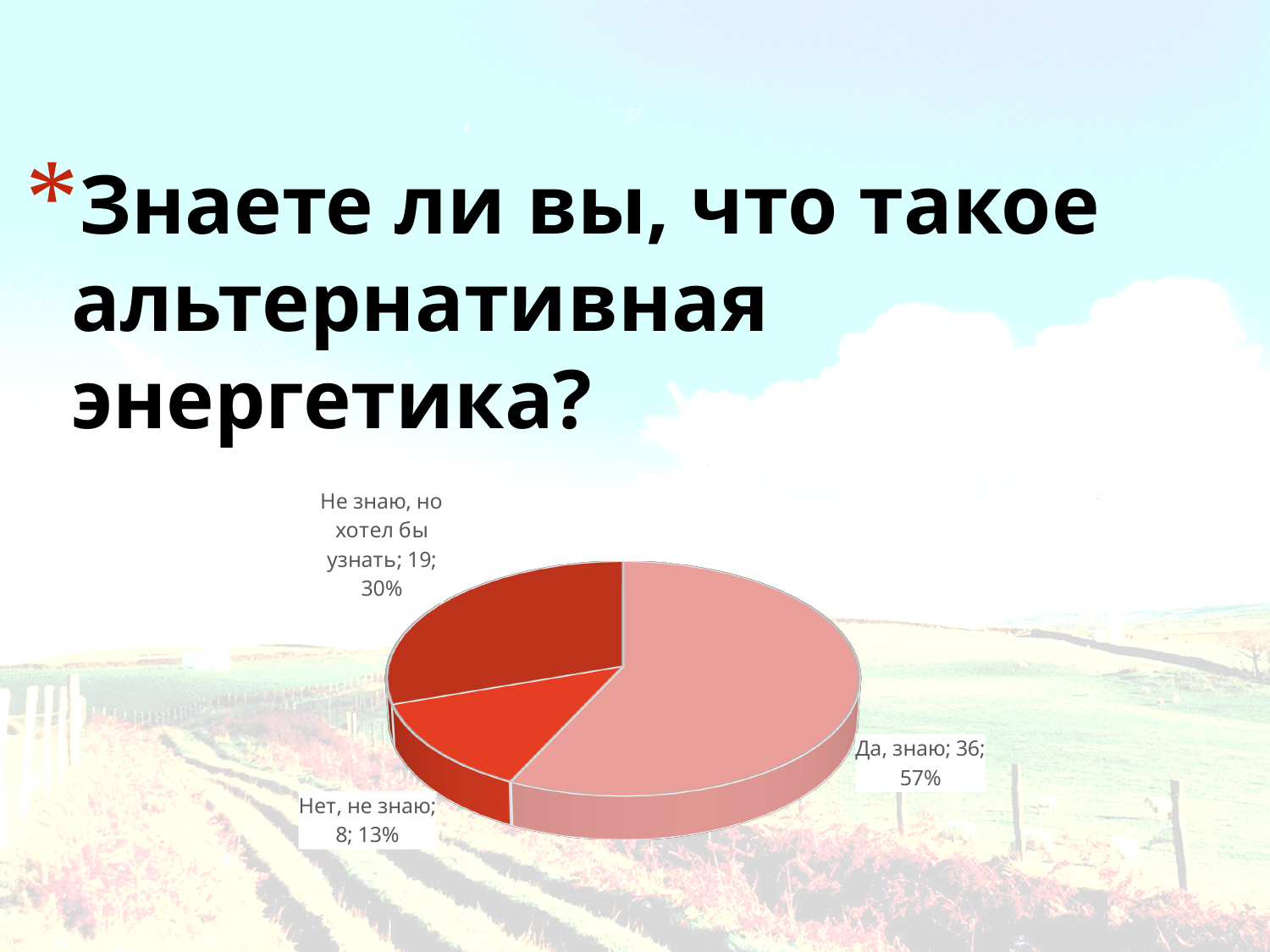
What is the value for "Нет, не знаю"? 8 Which category has the smallest slice? Нет, не знаю What is the value for "Не знаю, но хотел бы узнать"? 19 Which category has the largest slice? Да, знаю What share of the pie does "Не знаю, но хотел бы узнать" represent? 30% What share of the pie does "Нет, не знаю" represent? 13% Which is larger: the value for "Не знаю, но хотел бы узнать" or "Нет, не знаю"? Не знаю, но хотел бы узнать How many slices does the pie chart have? 3 What is the difference between the values for "Да, знаю" and "Не знаю, но хотел бы узнать"? 17 What share of the pie does "Да, знаю" represent? 57% What kind of chart is shown on the slide? pie chart What is the value for "Да, знаю"? 36